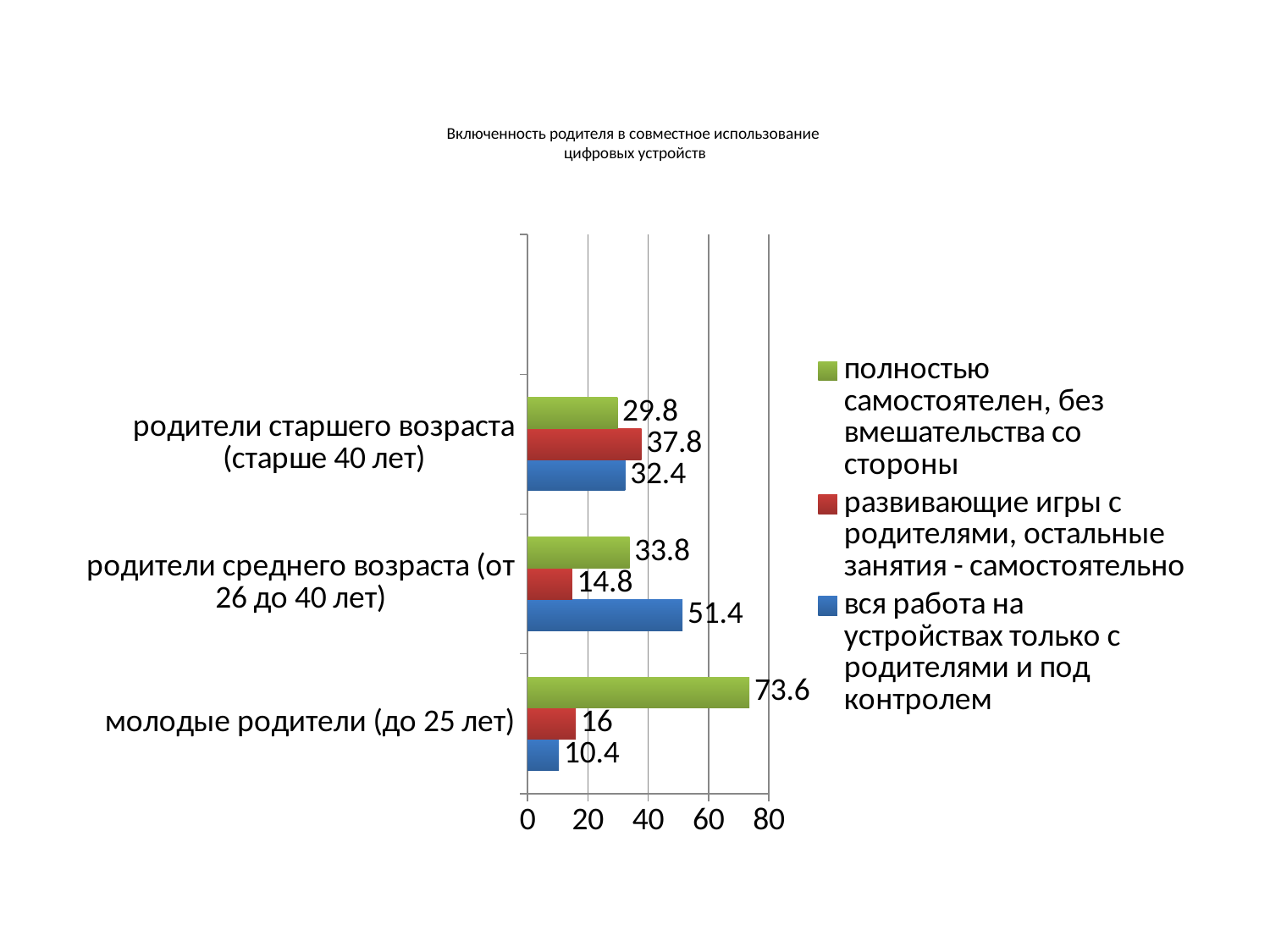
What is the value for 'родители среднего возраста (от 26 до 40 лет)' in the series 'вся работа на устройствах только с родителями и под контролем'? 51.4 What is the value for 'молодые родители (до 25 лет)' in the series 'полностью самостоятелен, без вмешательства со стороны'? 73.6 What type of chart is shown on the slide? bar chart What is the difference between the 'полностью самостоятелен' value and the 'вся работа на устройствах только с родителями и под контролем' value for 'молодые родители (до 25 лет)'? 63.2 How many categories are shown on the chart? 3 What is the title of the chart? Включенность родителя в совместное использование цифровых устройств Is the value for 'родители старшего возраста (старше 40 лет)' in the series 'вся работа на устройствах только с родителями и под контролем' greater or less than 40? less Which category has the highest value in the series 'полностью самостоятелен, без вмешательства со стороны'? молодые родители (до 25 лет) What is the value for 'родители старшего возраста (старше 40 лет)' in the series 'развивающие игры с родителями, остальные занятия - самостоятельно'? 37.8 For 'родители среднего возраста (от 26 до 40 лет)', which is larger: the 'полностью самостоятелен' value or the 'вся работа на устройствах только с родителями и под контролем' value? вся работа на устройствах только с родителями и под контролем How many series does the legend list? 3 Which category has the lowest value in the series 'вся работа на устройствах только с родителями и под контролем'? молодые родители (до 25 лет)